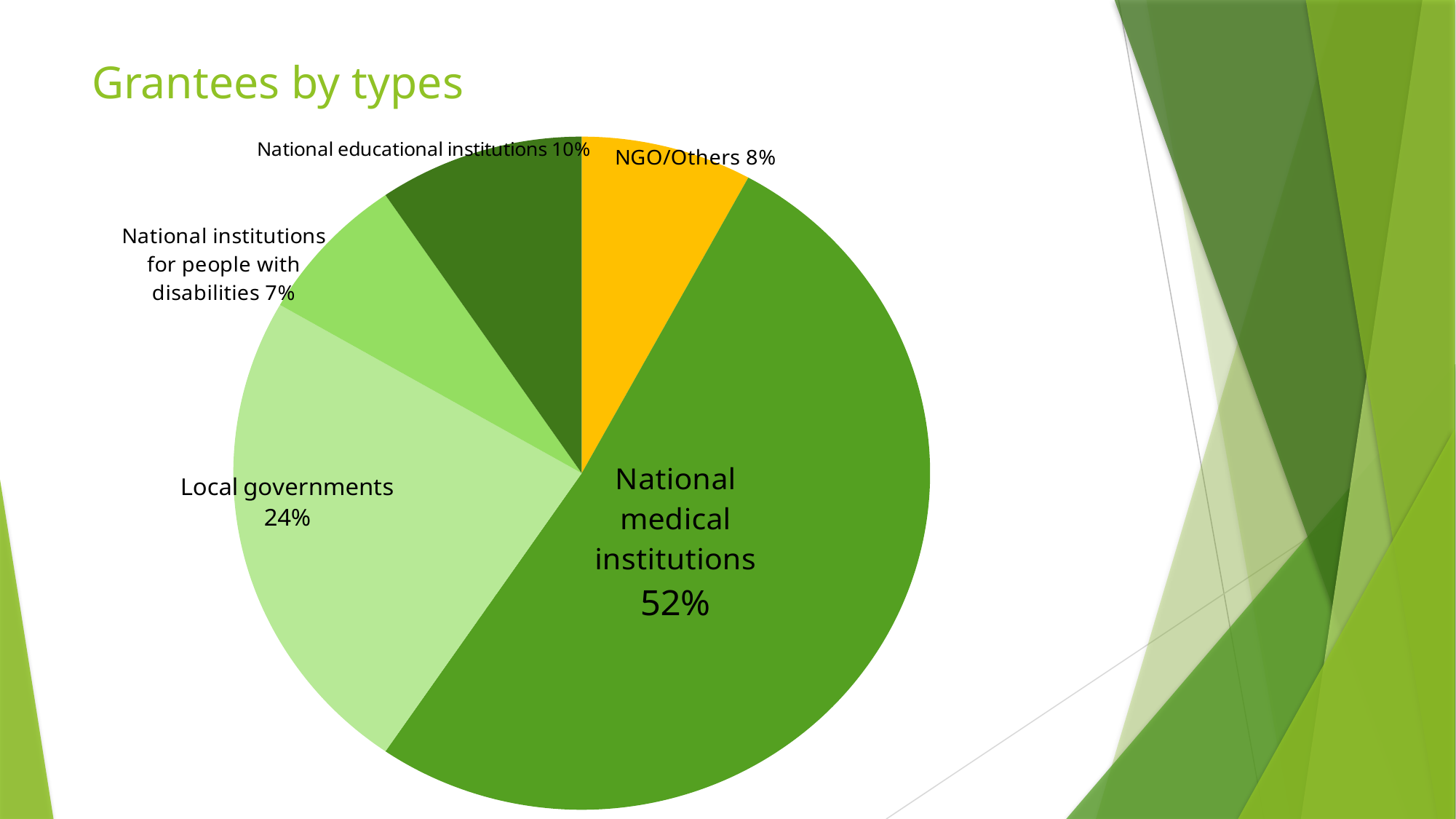
What share of grantees are National institutions for people with disabilities? 7% Which grantee type has the largest share? National medical institutions What share of grantees are National medical institutions? 52% What share of grantees are Local governments? 24% Which grantee type has the smallest share? National institutions for people with disabilities What share of grantees are National educational institutions? 10% How many grantee types are shown in the pie chart? 5 What is the difference in percentage points between National medical institutions and Local governments? 28 What share of grantees are NGO/Others? 8% What type of chart is shown on the slide? pie chart Which has a larger share, National educational institutions or NGO/Others? National educational institutions What is the title of the chart? Grantees by types